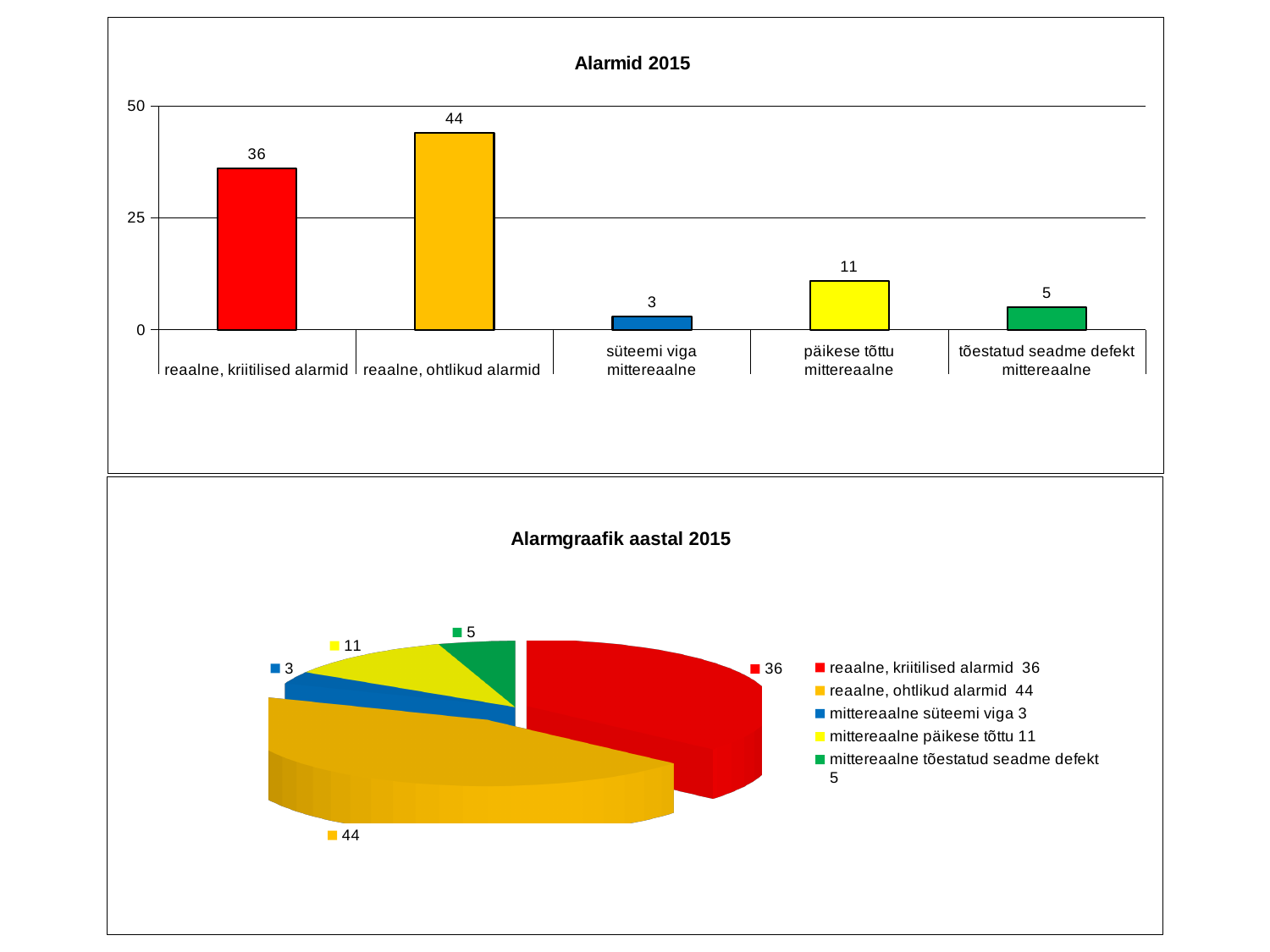
In the 'Alarmgraafik aastal 2015' pie chart, what colour is the slice for 'reaalne, kriitilised alarmid'? red In the 'Alarmid 2015' bar chart, what is the value for 'süteemi viga mittereaalne'? 3 How many categories are shown in the 'Alarmid 2015' bar chart? 5 In the 'Alarmid 2015' bar chart, what is the difference between 'reaalne, ohtlikud alarmid' and 'reaalne, kriitilised alarmid'? 8 In the 'Alarmid 2015' bar chart, which category has the lowest value? süteemi viga mittereaalne In the 'Alarmid 2015' bar chart, is the value for 'reaalne, kriitilised alarmid' greater or less than 25? greater In the 'Alarmid 2015' bar chart, which is larger: 'päikese tõttu mittereaalne' or 'tõestatud seadme defekt mittereaalne'? päikese tõttu mittereaalne What kind of chart is the bottom chart titled 'Alarmgraafik aastal 2015'? pie chart In the 'Alarmid 2015' bar chart, which category has the highest value? reaalne, ohtlikud alarmid In the 'Alarmid 2015' bar chart, what is the value for 'reaalne, ohtlikud alarmid'? 44 What kind of chart is the top chart titled 'Alarmid 2015'? bar chart In the 'Alarmgraafik aastal 2015' pie chart, what is the value for 'mittereaalne päikese tõttu'? 11